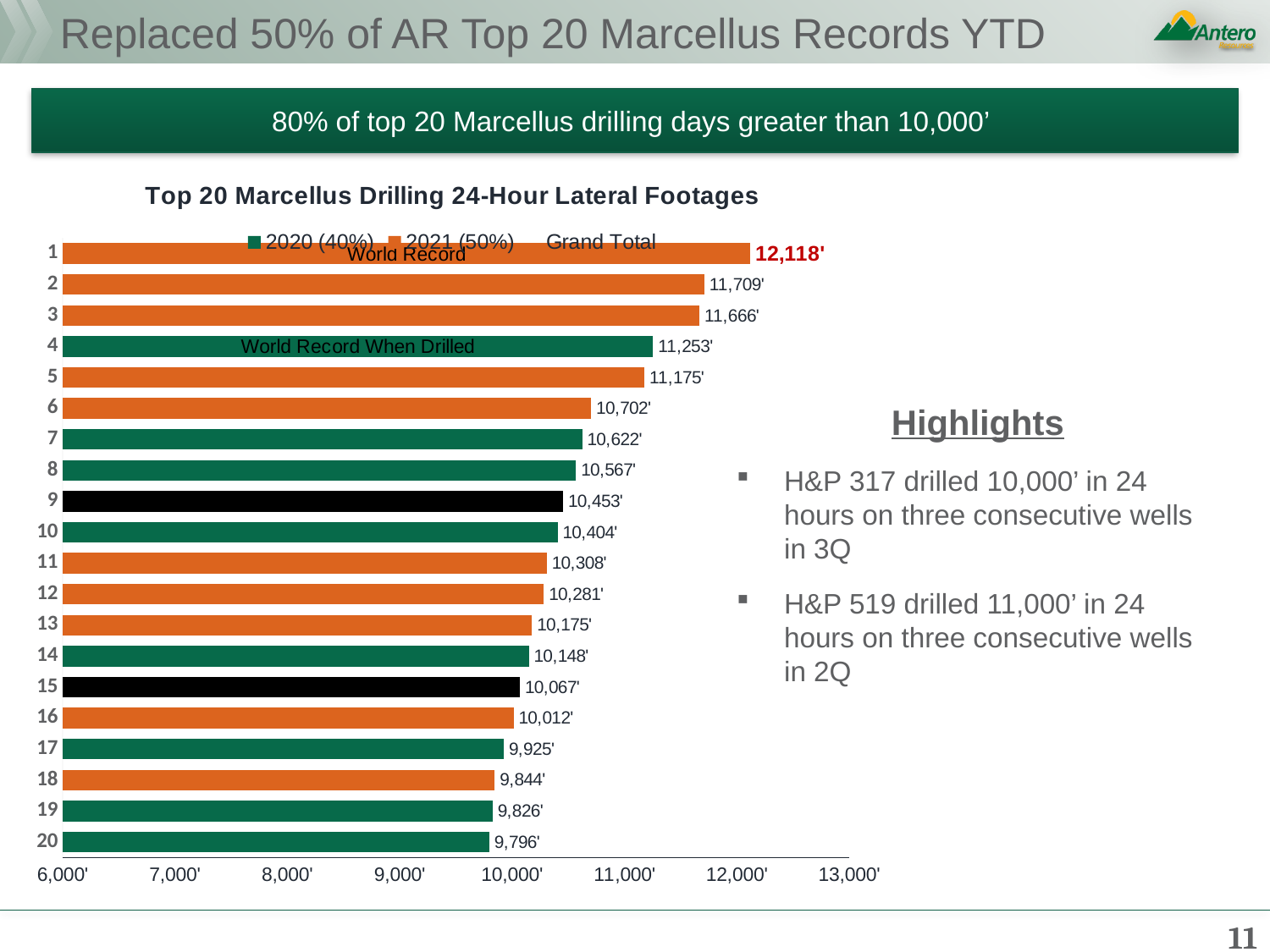
Which rank has the highest lateral footage in the chart? 1 Which is larger, the value for rank 4 or the value for rank 5? Rank 4 How many ranked bars are shown in the chart? 20 What is the value for rank 9 in the chart? 10,453' What is the value for rank 20 in the chart? 9,796' Is the value for rank 16 greater or less than 10,000'? greater What is the title of the chart on the slide? Top 20 Marcellus Drilling 24-Hour Lateral Footages What is the value for rank 1 in the Top 20 Marcellus Drilling 24-Hour Lateral Footages chart? 12,118' What is the difference between the values for rank 1 and rank 2? 409' How many series does the chart legend list? 3 Which rank has the lowest lateral footage in the chart? 20 What type of chart is shown on the slide? Bar chart